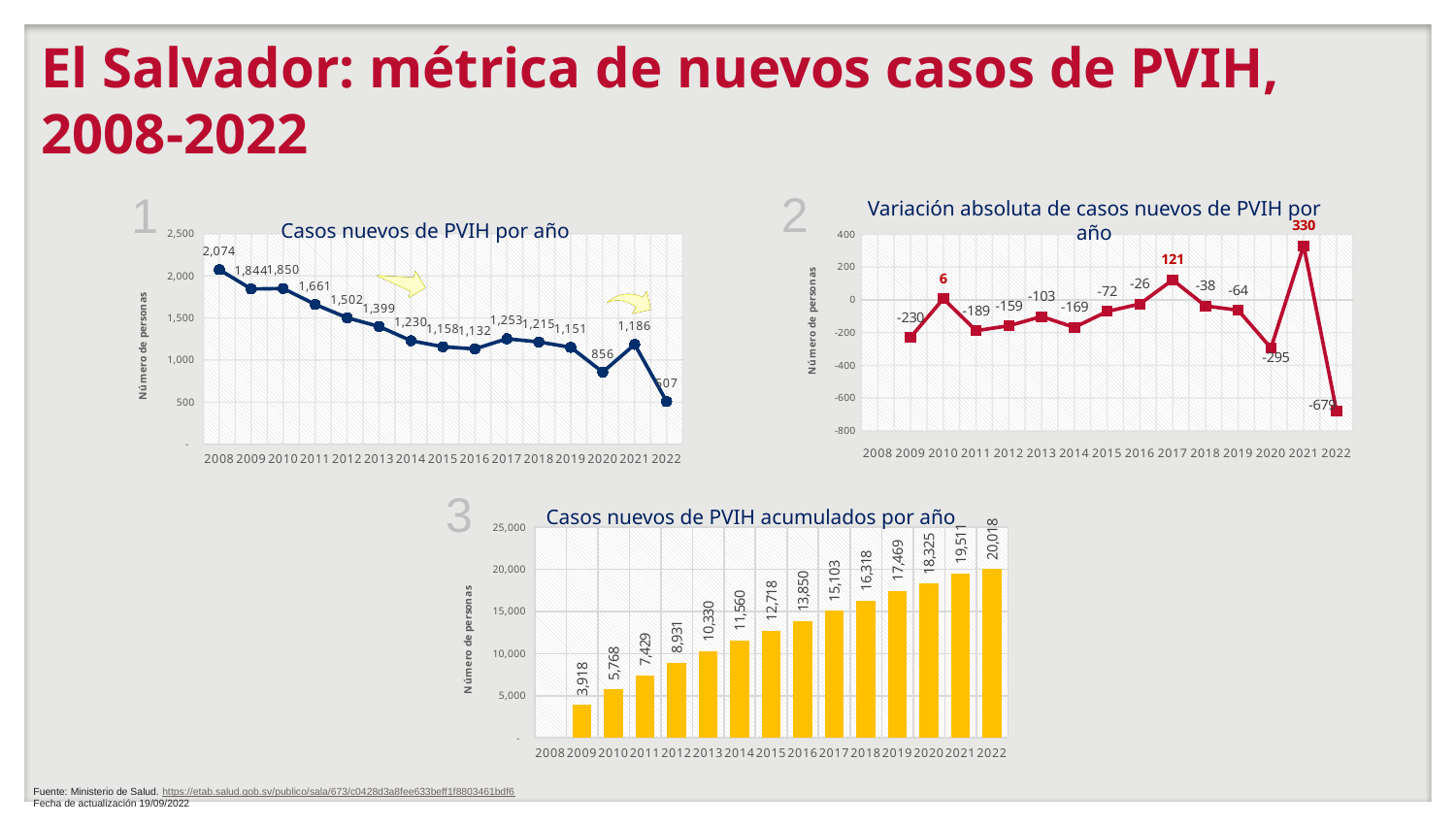
In the chart 'Casos nuevos de PVIH acumulados por año', what is the value for 2015? 12,718 In the chart 'Casos nuevos de PVIH por año', what is the difference between the values for 2008 and 2022? 1,567 In the chart 'Casos nuevos de PVIH por año', what is the overall trend of the values from 2008 to 2022? Falling In the chart 'Casos nuevos de PVIH acumulados por año', what is the value for 2022? 20,018 In the chart 'Variación absoluta de casos nuevos de PVIH por año', what is the value for 2021? 330 In the chart 'Variación absoluta de casos nuevos de PVIH por año', which year has the highest value? 2021 In the chart 'Casos nuevos de PVIH acumulados por año', is the value for 2019 greater or less than 15,000? greater In the chart 'Casos nuevos de PVIH por año', which year has the lowest value? 2022 In the chart 'Casos nuevos de PVIH por año', what is the value for 2020? 856 In the chart 'Variación absoluta de casos nuevos de PVIH por año', what is the value for 2022? -679 What kind of chart is 'Casos nuevos de PVIH acumulados por año'? Bar chart In the chart 'Casos nuevos de PVIH por año', what is the value for 2008? 2,074